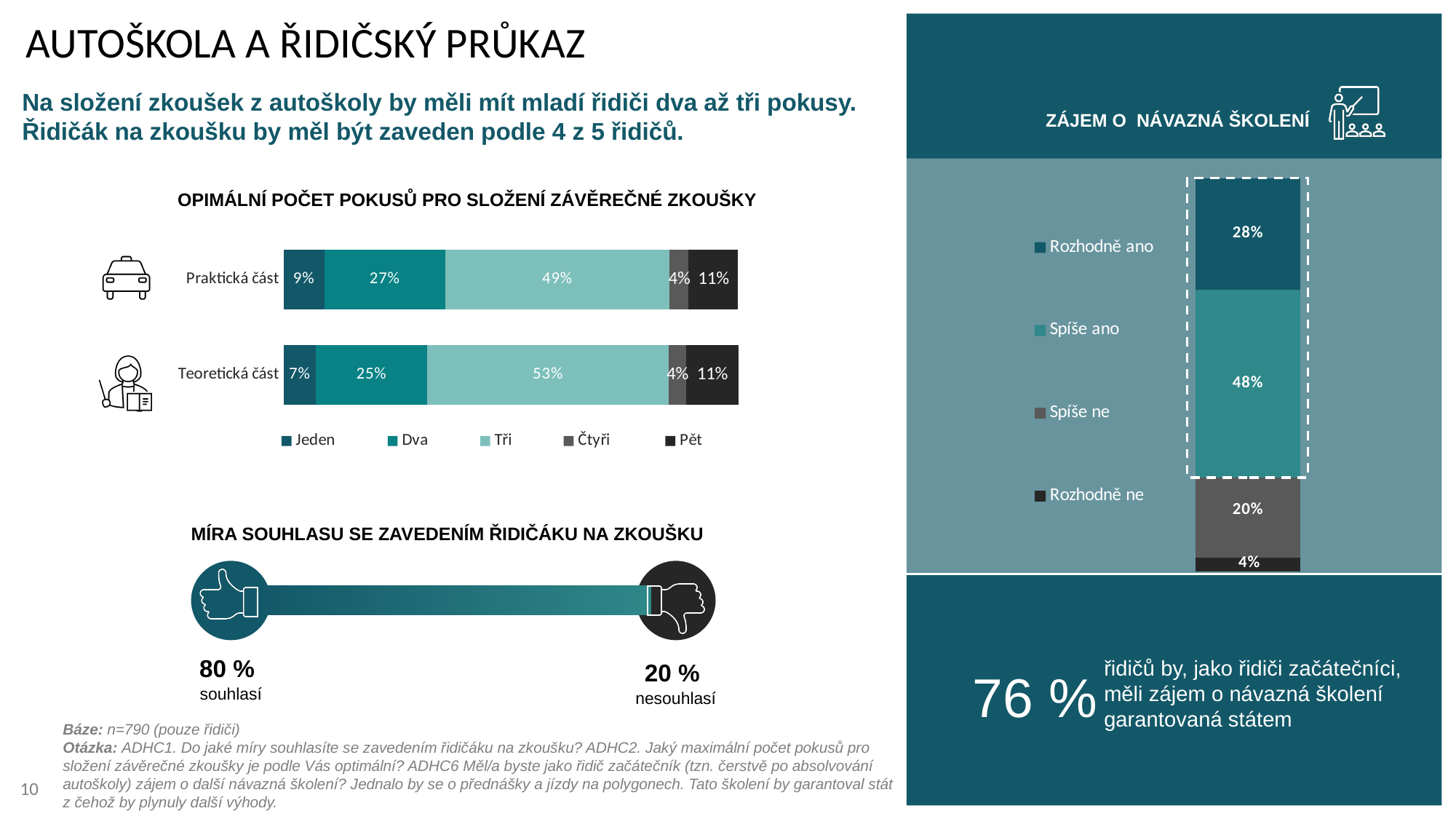
In the chart 'OPIMÁLNÍ POČET POKUSŮ PRO SLOŽENÍ ZÁVĚREČNÉ ZKOUŠKY', how many series does the legend list? 5 In the chart 'OPIMÁLNÍ POČET POKUSŮ PRO SLOŽENÍ ZÁVĚREČNÉ ZKOUŠKY', what is the value for 'Jeden' in the 'Praktická část' bar? 9% In the chart 'ZÁJEM O NÁVAZNÁ ŠKOLENÍ', what is the total of 'Rozhodně ano' and 'Spíše ano'? 76% In the chart 'ZÁJEM O NÁVAZNÁ ŠKOLENÍ', which is larger, 'Rozhodně ano' or 'Spíše ne'? Rozhodně ano In the chart 'OPIMÁLNÍ POČET POKUSŮ PRO SLOŽENÍ ZÁVĚREČNÉ ZKOUŠKY', what is the value for 'Tři' in the 'Praktická část' bar? 49% In the chart 'OPIMÁLNÍ POČET POKUSŮ PRO SLOŽENÍ ZÁVĚREČNÉ ZKOUŠKY', what is the difference between the 'Tři' values for 'Teoretická část' and 'Praktická část'? 4% In the chart 'OPIMÁLNÍ POČET POKUSŮ PRO SLOŽENÍ ZÁVĚREČNÉ ZKOUŠKY', which series has the smallest share in the 'Praktická část' bar? Čtyři What kind of chart is 'OPIMÁLNÍ POČET POKUSŮ PRO SLOŽENÍ ZÁVĚREČNÉ ZKOUŠKY'? Stacked bar chart In the chart 'ZÁJEM O NÁVAZNÁ ŠKOLENÍ', what is the value for 'Rozhodně ne'? 4% In the chart 'ZÁJEM O NÁVAZNÁ ŠKOLENÍ', what is the value for 'Spíše ano'? 48% In the chart 'OPIMÁLNÍ POČET POKUSŮ PRO SLOŽENÍ ZÁVĚREČNÉ ZKOUŠKY', which series has the largest share in the 'Teoretická část' bar? Tři In the chart 'OPIMÁLNÍ POČET POKUSŮ PRO SLOŽENÍ ZÁVĚREČNÉ ZKOUŠKY', what is the value for 'Dva' in the 'Teoretická část' bar? 25%